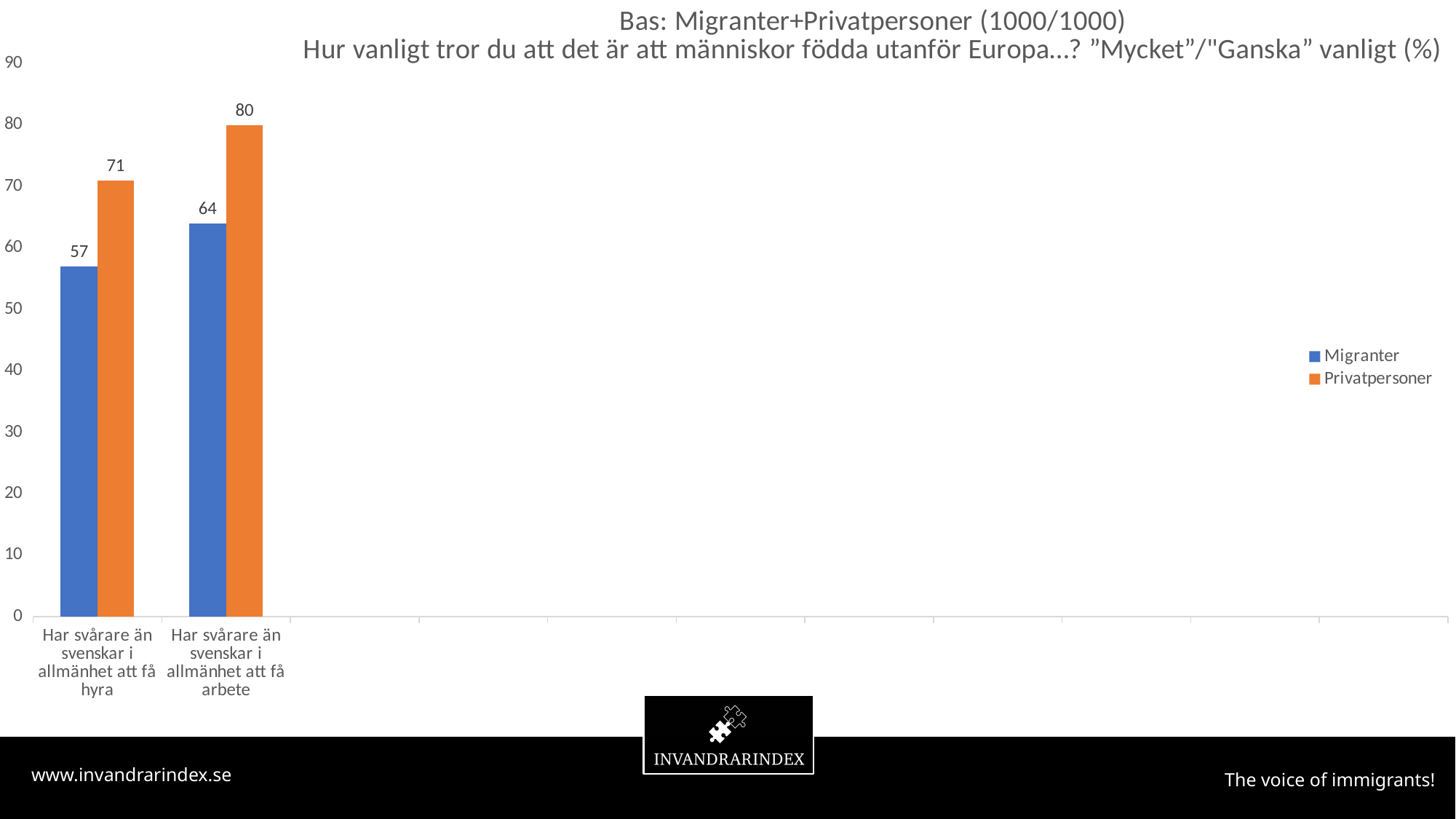
What is the value for Privatpersoner in the category 'Har svårare än svenskar i allmänhet att få arbete'? 80 What is the value for Migranter in the category 'Har svårare än svenskar i allmänhet att få arbete'? 64 Which is larger: the Migranter value for 'att få arbete' or the Privatpersoner value for 'att få hyra'? Privatpersoner value for 'att få hyra' Which series has the highest value in the category 'Har svårare än svenskar i allmänhet att få arbete'? Privatpersoner What is the value for Migranter in the category 'Har svårare än svenskar i allmänhet att få hyra'? 57 What is the difference between Privatpersoner and Migranter in the category 'Har svårare än svenskar i allmänhet att få hyra'? 14 Which bar has the lowest value on the chart? Migranter, Har svårare än svenskar i allmänhet att få hyra How many categories are shown on the x axis? 2 What kind of chart is shown on the slide? Bar chart What is the difference between the Privatpersoner values for 'att få arbete' and 'att få hyra'? 9 What is the value for Privatpersoner in the category 'Har svårare än svenskar i allmänhet att få hyra'? 71 How many series does the legend list? 2